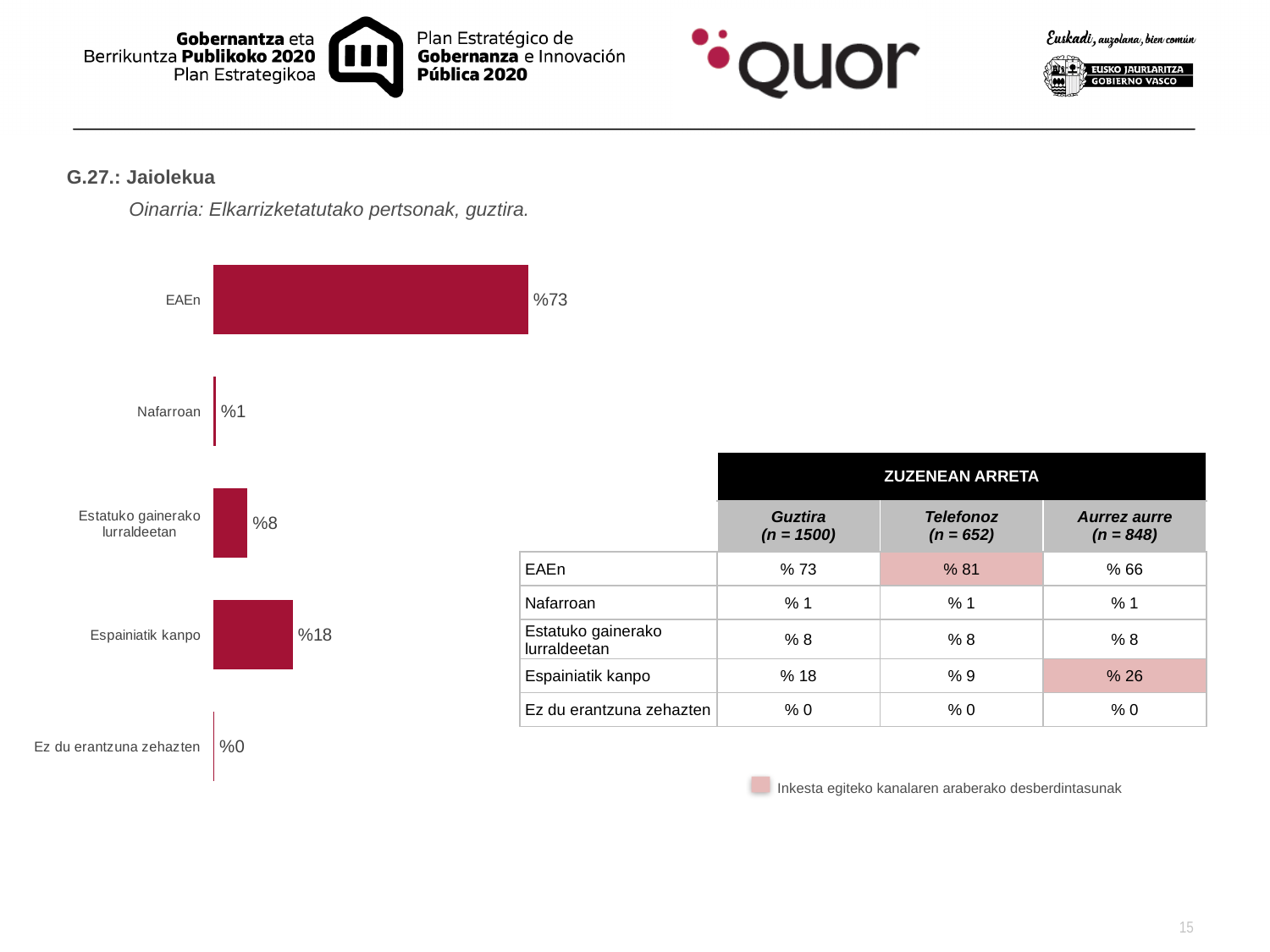
What is the value for Estatuko gainerako lurraldeetan in the bar chart? %8 What is the difference between the values for EAEn and Espainiatik kanpo in the bar chart? %55 Which category has the highest value in the bar chart? EAEn What is the title of the chart on the slide? G.27.: Jaiolekua Which is larger in the bar chart, Espainiatik kanpo or Estatuko gainerako lurraldeetan? Espainiatik kanpo What is the difference between the values for Estatuko gainerako lurraldeetan and Nafarroan in the bar chart? %7 How many categories are shown in the bar chart? 5 What kind of chart is shown on the slide? Bar chart What is the value for Espainiatik kanpo in the bar chart? %18 What is the value for EAEn in the bar chart? %73 Which category has the lowest value in the bar chart? Ez du erantzuna zehazten What is the value for Nafarroan in the bar chart? %1